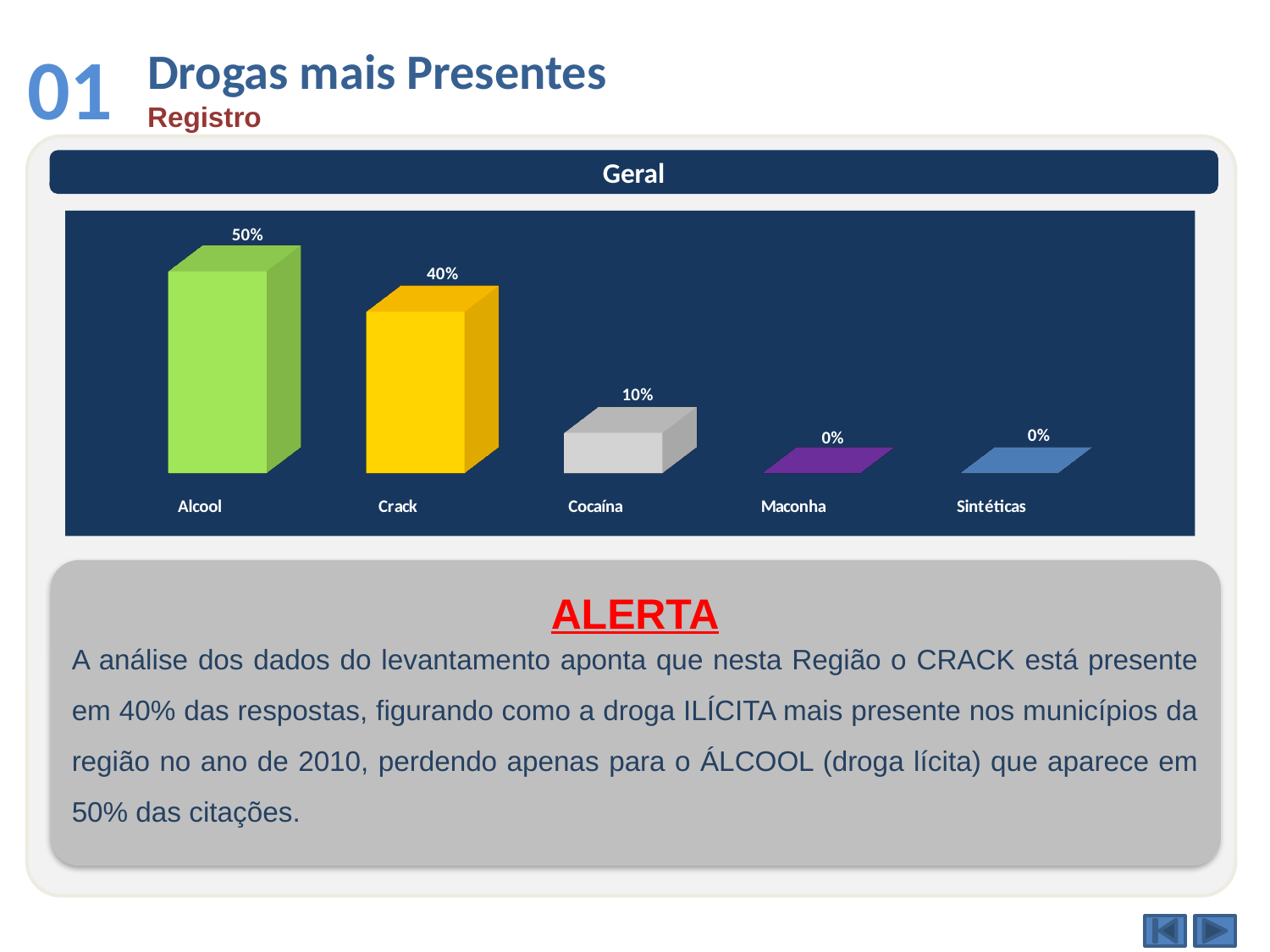
What is the value for Maconha? 0% How many categories are shown in the chart? 5 What is the value for Cocaína? 10% What is the difference between the values for Crack and Cocaína? 30% What is the value for Crack? 40% Which category has the highest value? Alcool What kind of chart is shown? bar chart What is the value for Alcool? 50% What is the title shown above the chart? Geral Do the values rise or fall from left to right across the categories? fall What is the difference between the values for Alcool and Crack? 10% Which is larger, the value for Crack or the value for Cocaína? Crack